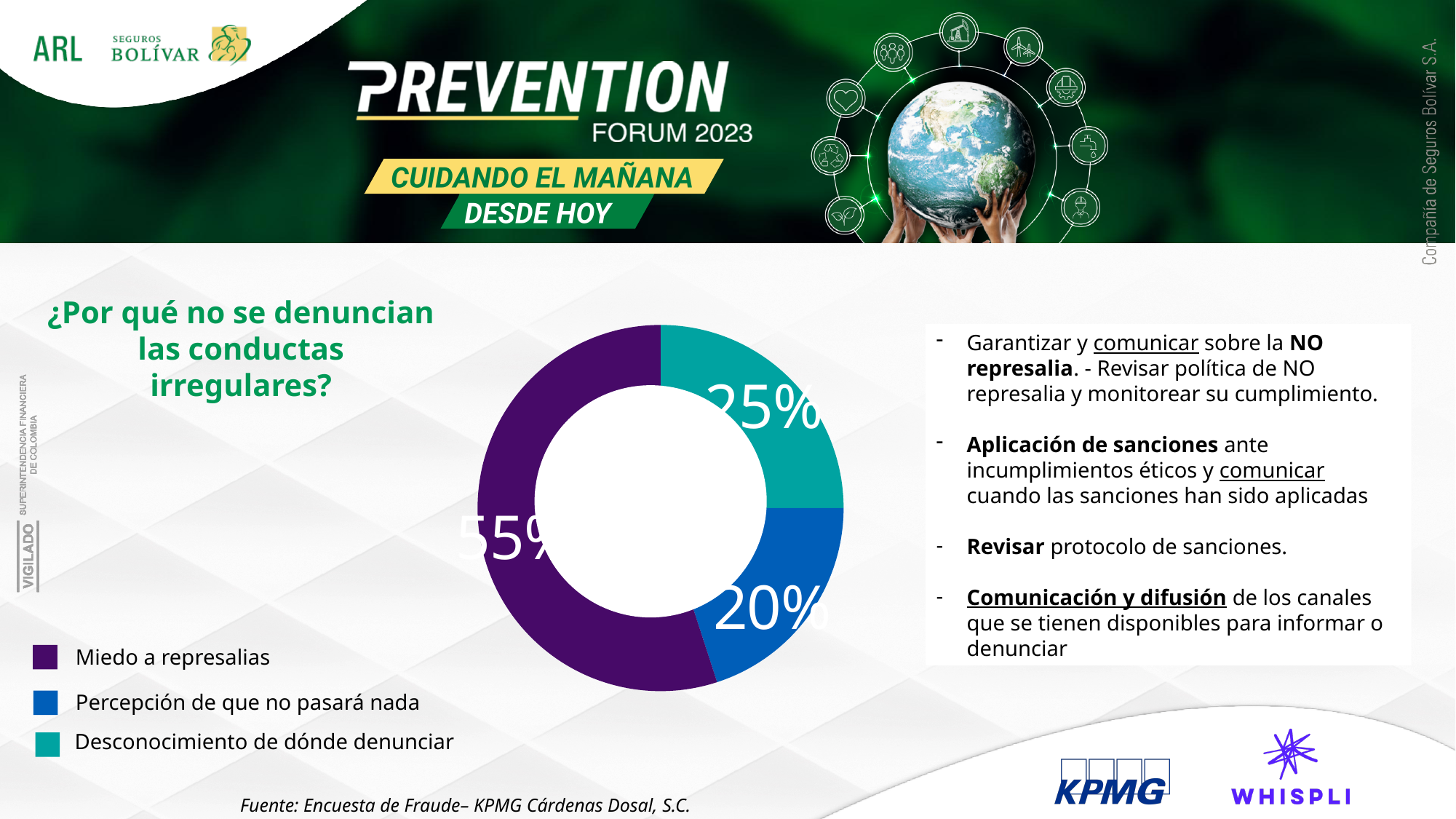
What is the title of the chart on the slide? ¿Por qué no se denuncian las conductas irregulares? How many categories are shown in the donut chart? 3 What percentage of the donut chart corresponds to "Percepción de que no pasará nada"? 20% What colour represents "Miedo a represalias" in the chart? Purple What is the difference in percentage points between "Desconocimiento de dónde denunciar" and "Percepción de que no pasará nada"? 5 percentage points What percentage of the donut chart corresponds to "Miedo a represalias"? 55% Which reason has the largest share in the donut chart? Miedo a represalias What is the difference in percentage points between "Miedo a represalias" and "Desconocimiento de dónde denunciar"? 30 percentage points What percentage of the donut chart corresponds to "Desconocimiento de dónde denunciar"? 25% What kind of chart is shown on the slide? Donut (pie) chart Which is larger: the share for "Desconocimiento de dónde denunciar" or the share for "Percepción de que no pasará nada"? Desconocimiento de dónde denunciar Which reason has the smallest share in the donut chart? Percepción de que no pasará nada